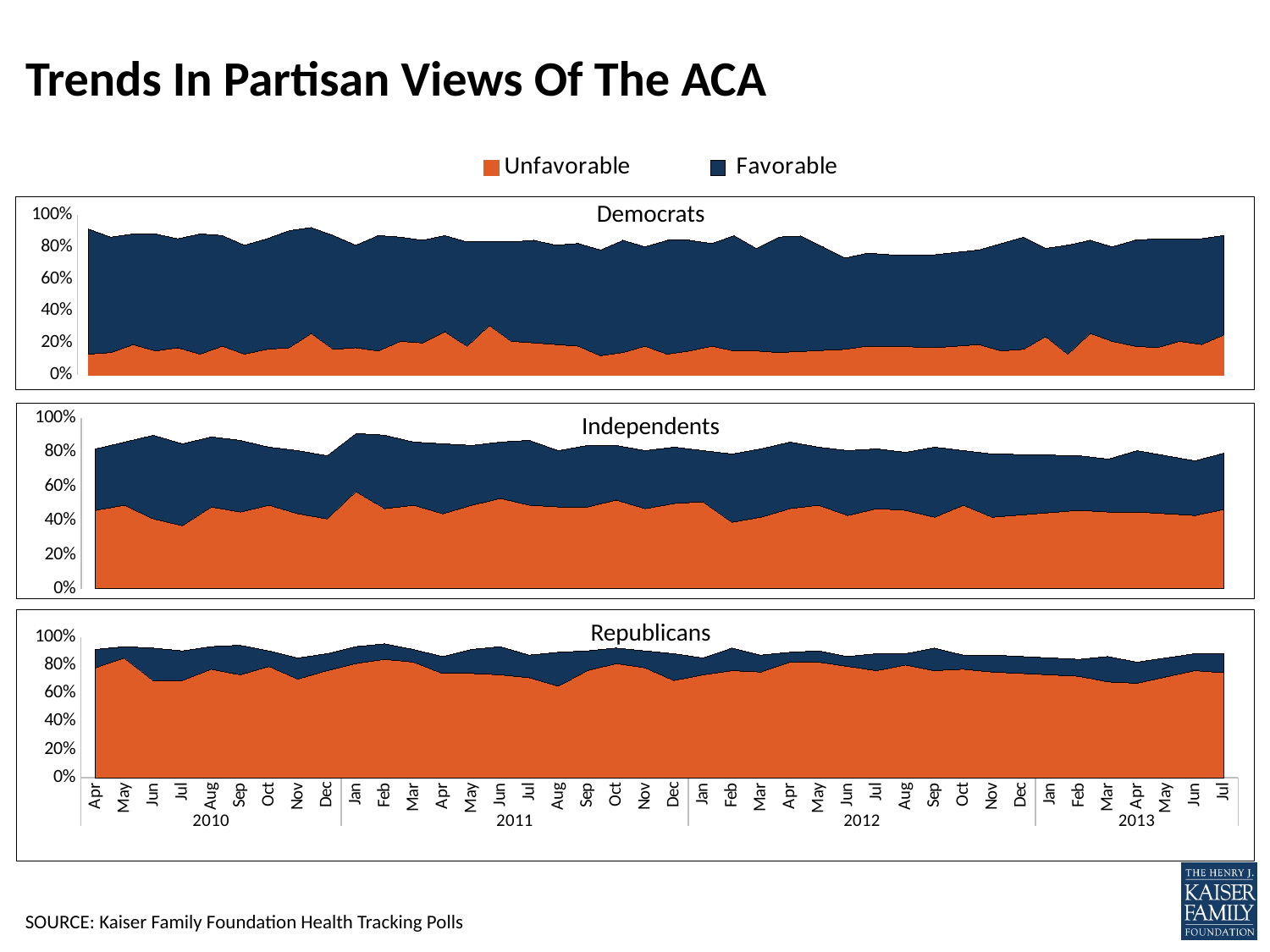
In the Republicans chart, is the Unfavorable value for Apr 2010 greater or less than 60%? greater In the Democrats chart, is the Unfavorable value for Apr 2010 greater or less than 20%? less In the Democrats chart, which series is larger in Apr 2010, Favorable or Unfavorable? Favorable What kind of chart is used for the Democrats panel? stacked area chart How many series does the legend list? 2 In the Independents chart, is the Unfavorable value for Jan 2011 greater or less than 40%? greater How many monthly points are plotted along the x axis, from Apr 2010 to Jul 2013? 40 What are the two series named in the legend? Unfavorable and Favorable In the Independents chart, which series is larger in Jan 2011, Favorable or Unfavorable? Unfavorable Which colour represents Unfavorable in the charts? orange In the Republicans chart, which series is larger in Jul 2013, Favorable or Unfavorable? Unfavorable